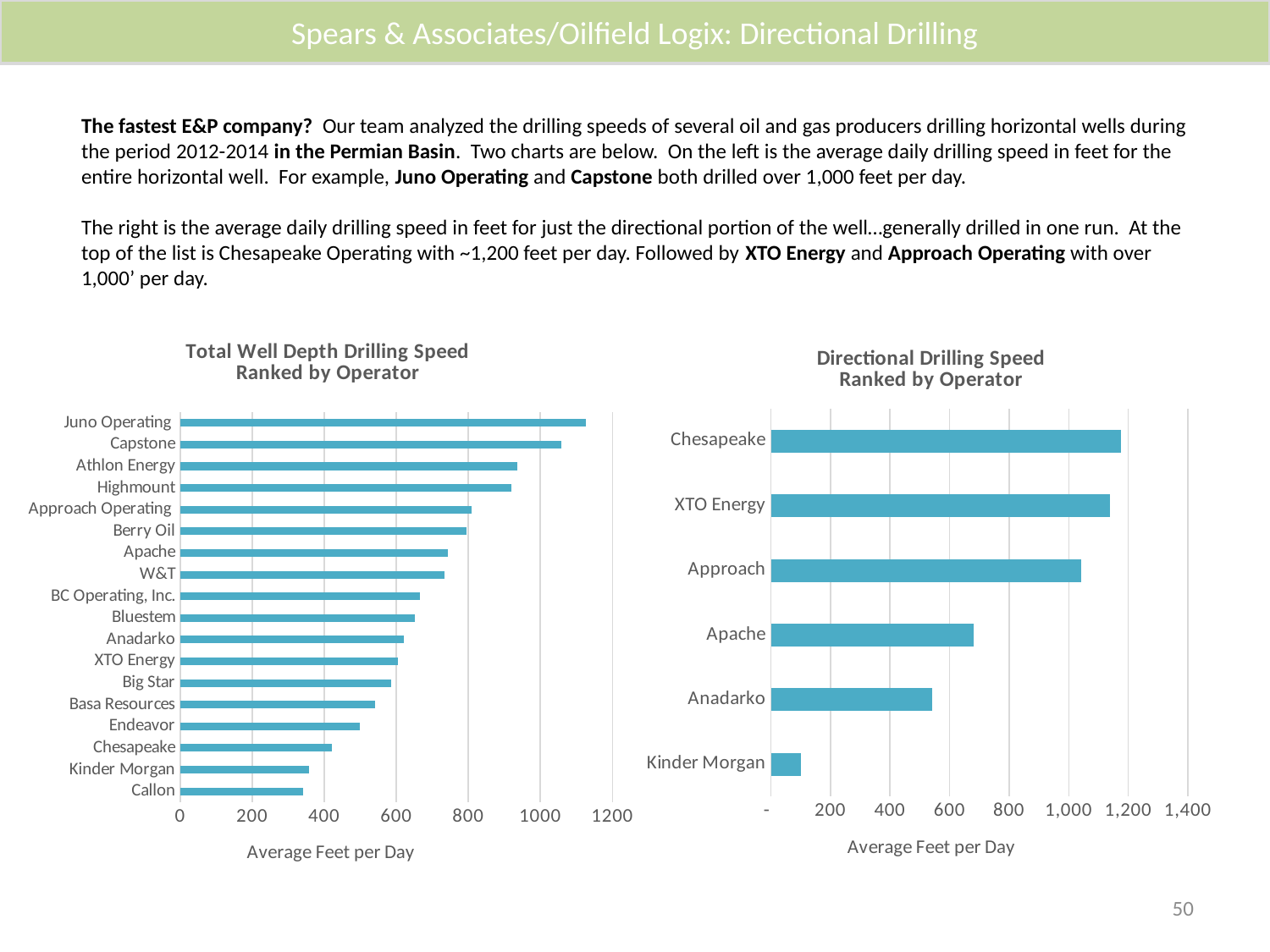
In the chart titled "Directional Drilling Speed Ranked by Operator", which operator has the highest value? Chesapeake In the chart titled "Directional Drilling Speed Ranked by Operator", is the value for Apache greater or less than 600? greater In the chart titled "Directional Drilling Speed Ranked by Operator", how many operators are listed? 6 In the chart titled "Total Well Depth Drilling Speed Ranked by Operator", how many operators are listed? 18 In the chart titled "Total Well Depth Drilling Speed Ranked by Operator", is the value for Chesapeake greater or less than 600? less In the chart titled "Total Well Depth Drilling Speed Ranked by Operator", which operator has the lowest value? Callon In the chart titled "Total Well Depth Drilling Speed Ranked by Operator", is the value for Juno Operating greater or less than 1000? greater In the chart titled "Total Well Depth Drilling Speed Ranked by Operator", which operator has the highest value? Juno Operating What kind of chart is the "Total Well Depth Drilling Speed Ranked by Operator" chart? Bar chart What is the x-axis label of the chart titled "Directional Drilling Speed Ranked by Operator"? Average Feet per Day In the chart titled "Directional Drilling Speed Ranked by Operator", which operator has the lowest value? Kinder Morgan In the chart titled "Total Well Depth Drilling Speed Ranked by Operator", which is larger, the value for Apache or the value for Anadarko? Apache